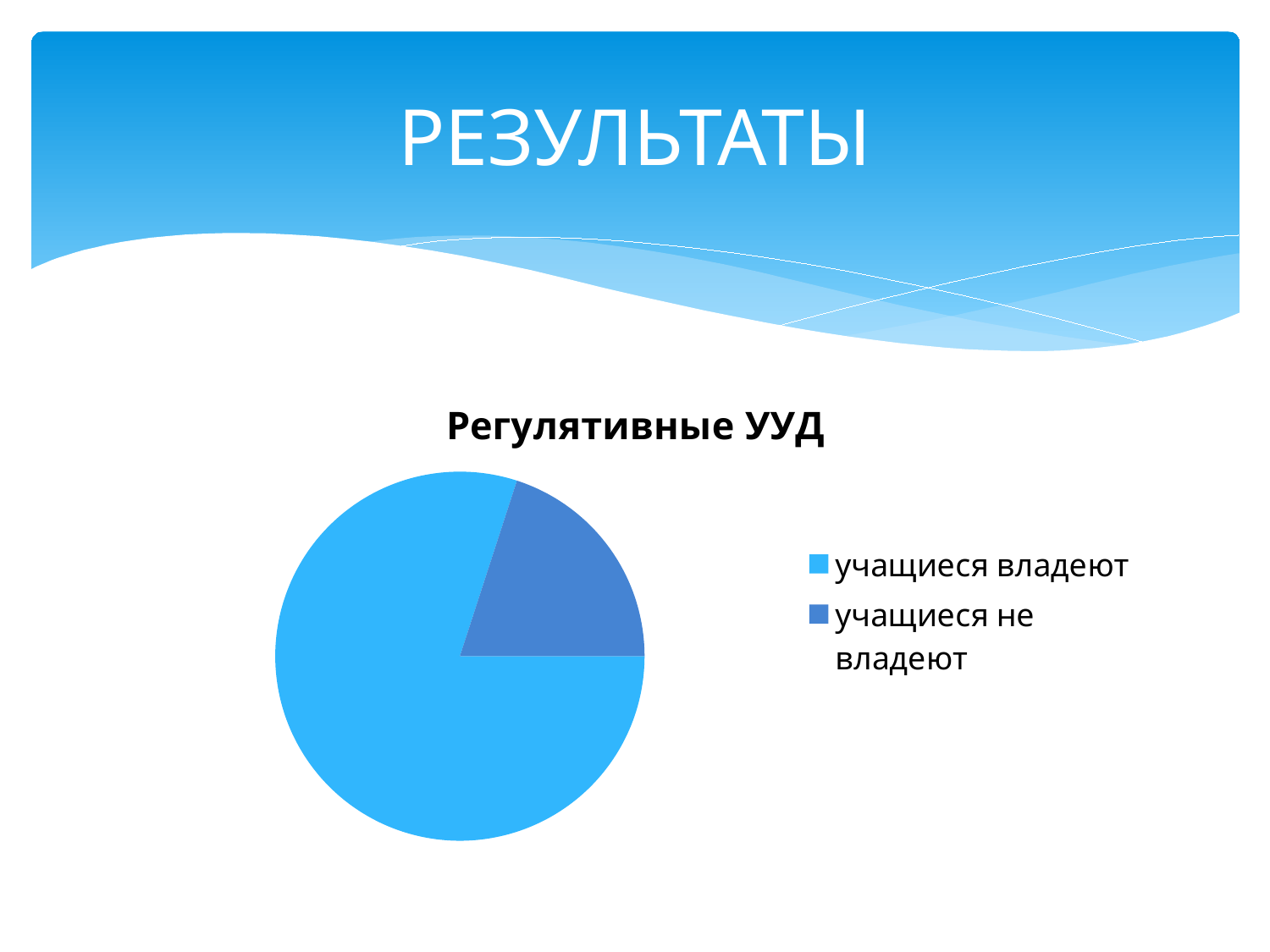
How many entries does the legend list? 2 Which is larger: the slice for учащиеся владеют or the slice for учащиеся не владеют? учащиеся владеют How many slices does the pie chart have? 2 What is the title of the chart? Регулятивные УУД Which category has the smallest slice of the pie? учащиеся не владеют What kind of chart is shown on the slide? pie chart What colour is the slice for учащиеся не владеют? dark blue Which category has the largest slice of the pie? учащиеся владеют